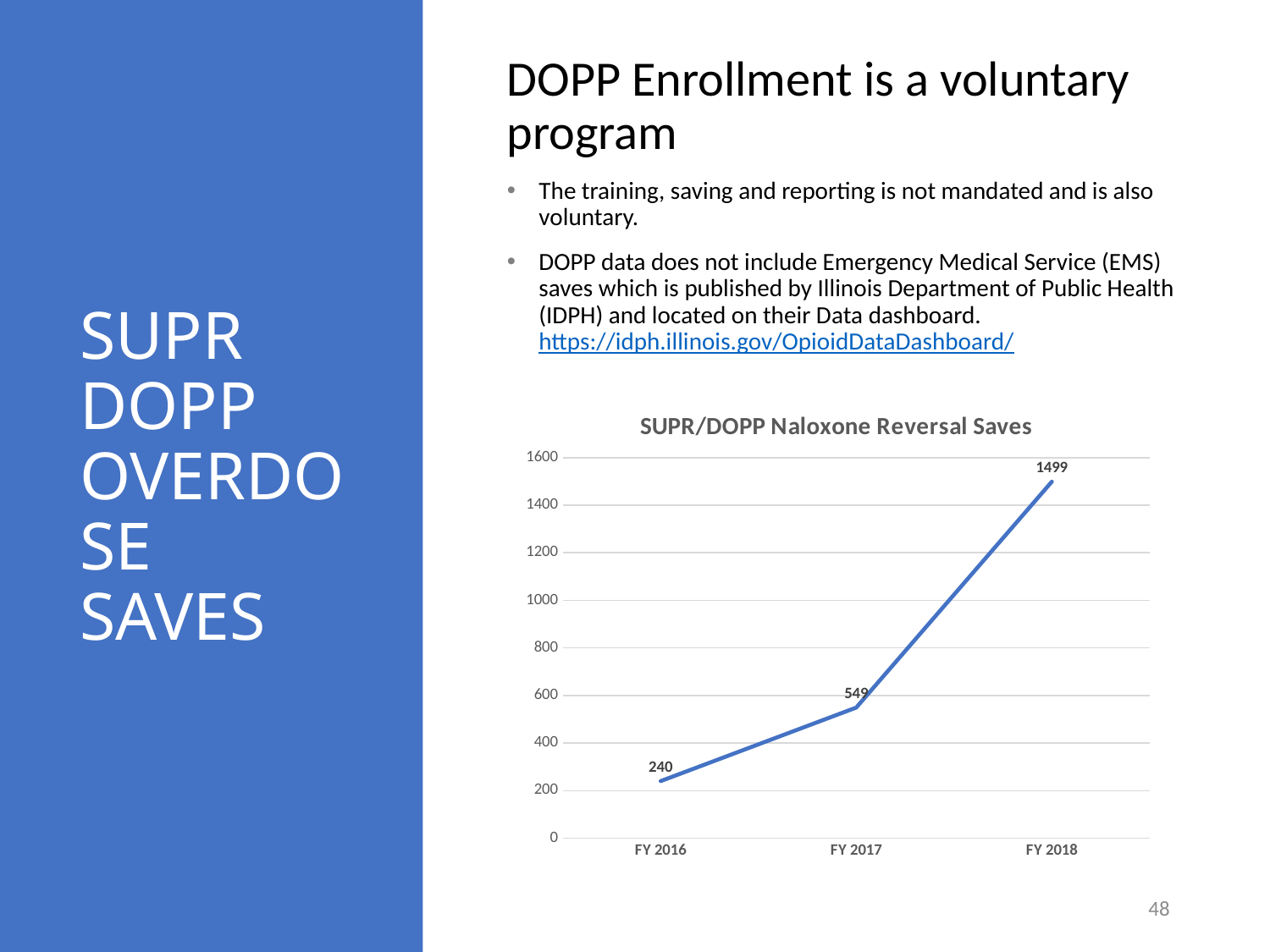
Which is larger, the value for FY 2017 or the value for FY 2016? FY 2017 What is the difference between the values for FY 2017 and FY 2016? 309 Do the values rise or fall from FY 2016 to FY 2018? rise What is the value for FY 2017? 549 What is the value for FY 2018? 1499 Is the value for FY 2018 greater or less than 1400? greater What is the difference between the values for FY 2018 and FY 2017? 950 Which fiscal year has the highest number of naloxone reversal saves? FY 2018 How many fiscal years are plotted on the chart? 3 What is the value for FY 2016? 240 Which fiscal year has the lowest number of naloxone reversal saves? FY 2016 What kind of chart is shown on the slide? line chart